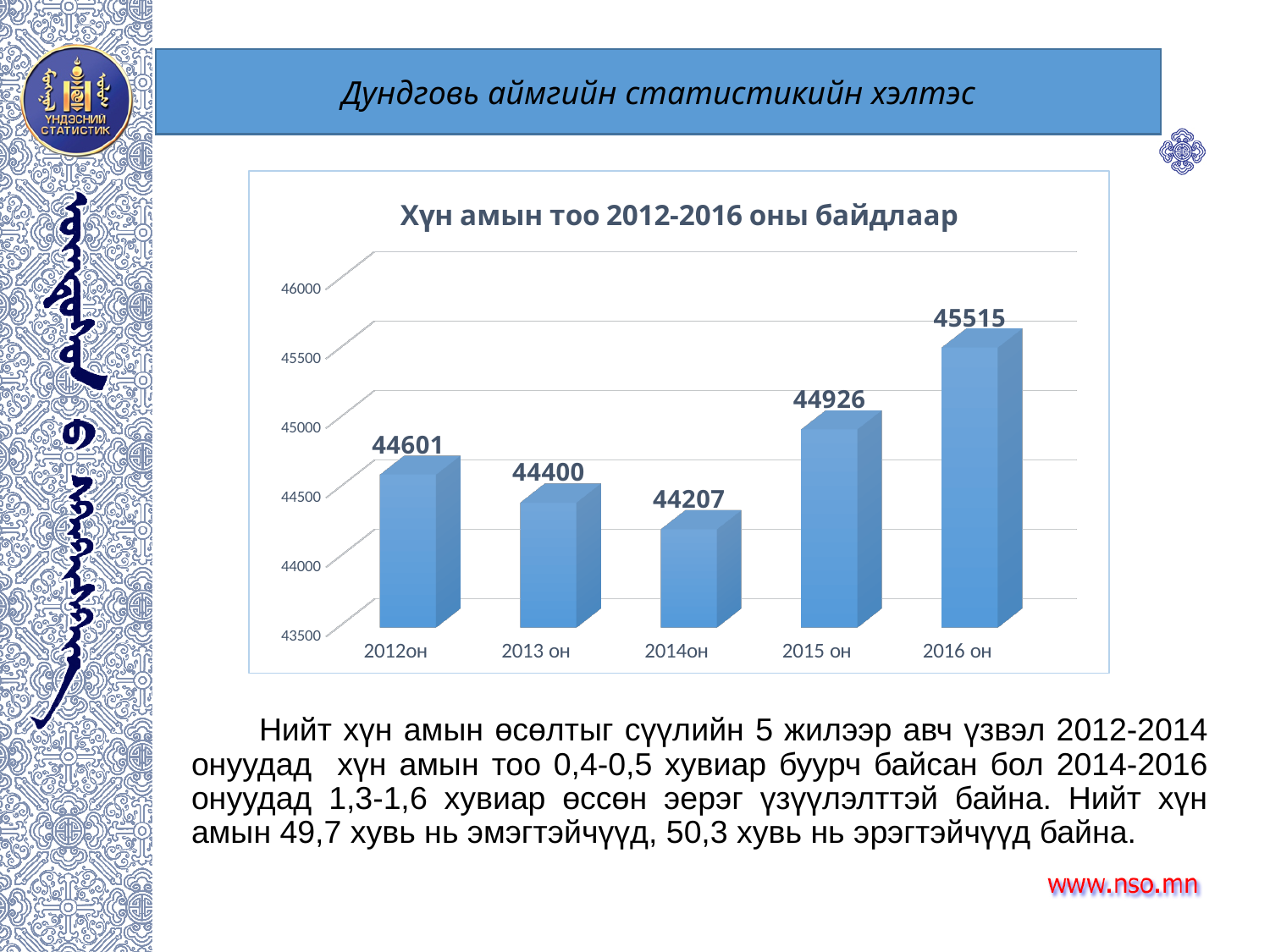
What is the difference between the values for 2016 он and 2015 он? 589 What is the value for 2012он? 44601 What is the title of the chart? Хүн амын тоо 2012-2016 оны байдлаар Which year has the lowest value? 2014он How many years are shown on the chart? 5 What kind of chart is shown? bar chart Is the value for 2015 он greater or less than 45000? less What is the value for 2016 он? 45515 What is the difference between the values for 2012он and 2014он? 394 Which is larger, the value for 2013 он or the value for 2015 он? 2015 он Which year has the highest value? 2016 он What is the value for 2014он? 44207